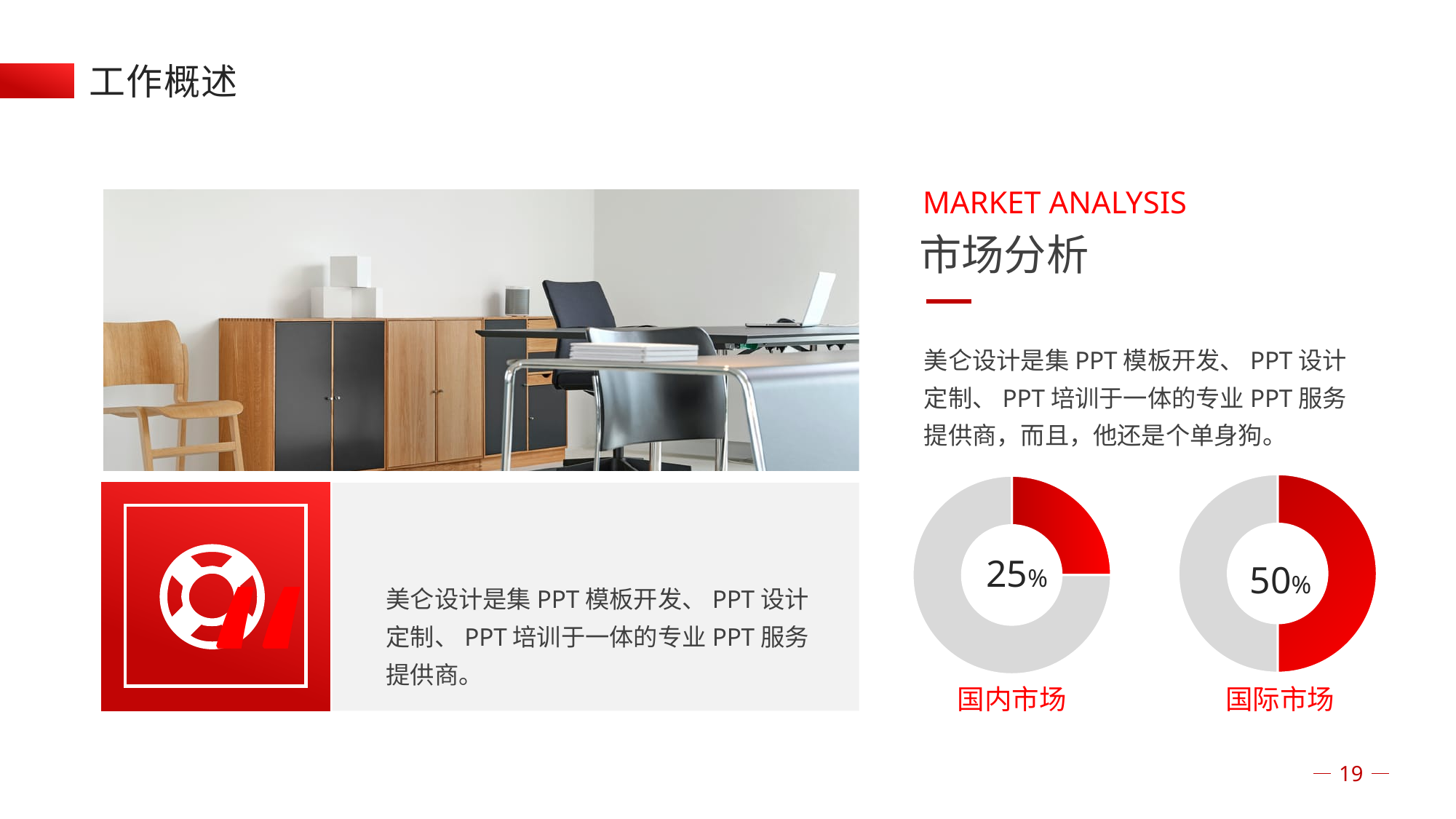
What value is shown in the centre of the 国际市场 doughnut chart? 50% What is the difference between the value shown for 国际市场 and the value shown for 国内市场? 25% Which of the two doughnut charts, 国内市场 or 国际市场, shows the larger value? 国际市场 What colour is the filled portion of the doughnut charts? red What is the label under the left doughnut chart? 国内市场 How many doughnut charts are shown on the slide? 2 What share of the 国内市场 doughnut chart is filled in red? 25% What share of the 国际市场 doughnut chart is filled in red? 50% Which of the two doughnut charts, 国内市场 or 国际市场, shows the smaller value? 国内市场 What kind of chart is used to show the 国内市场 and 国际市场 values? doughnut chart What value is shown in the centre of the 国内市场 doughnut chart? 25%